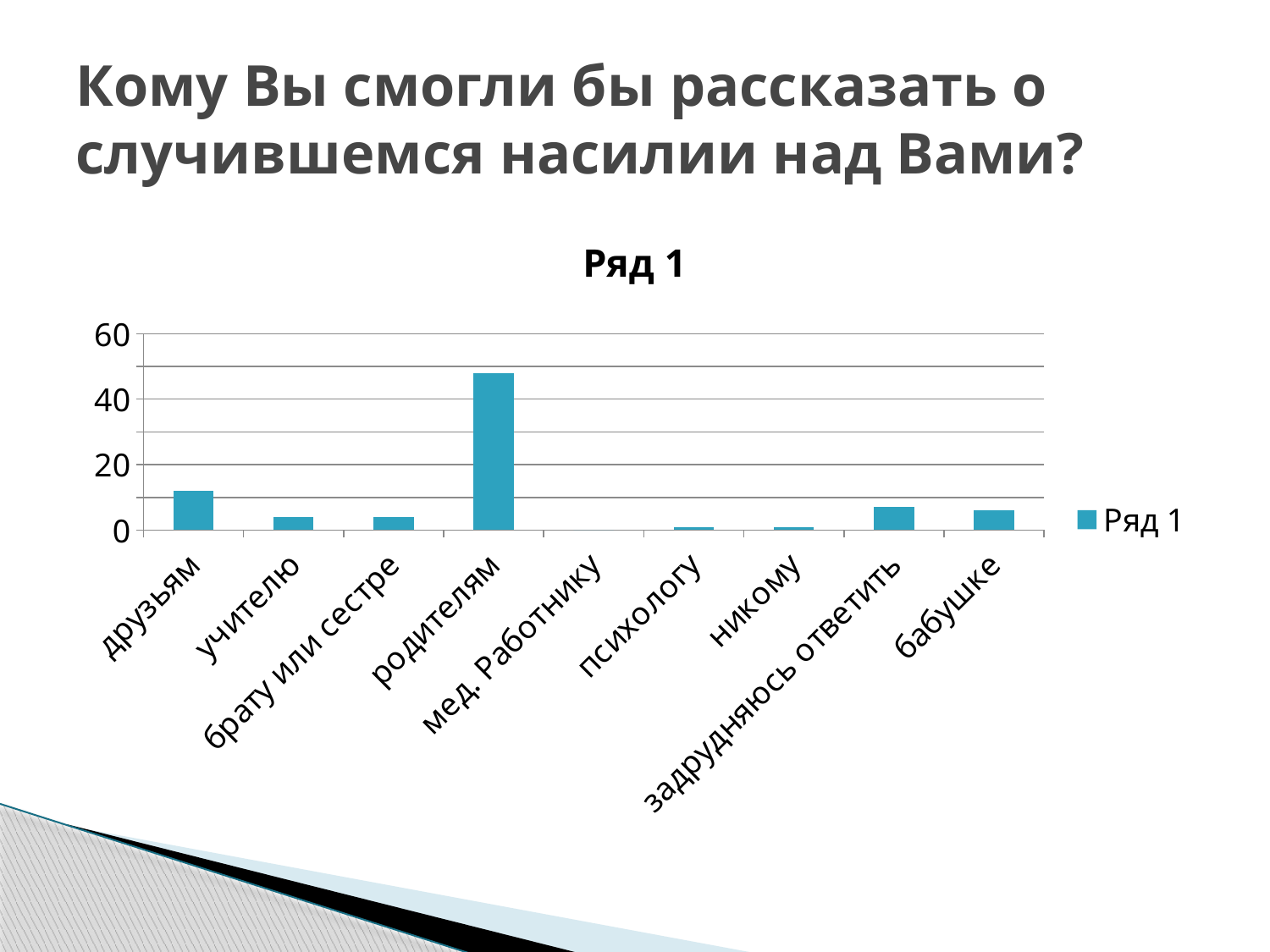
How many series does the legend list? 1 Is the value for родителям greater or less than 40? greater Which category has the lowest value? мед. Работнику Is the value for родителям greater or less than 60? less Which is larger, the value for родителям or the value for друзьям? родителям How many categories are shown on the x axis? 9 What is the title of the chart? Ряд 1 Which is larger, the value for задрудняюсь ответить or the value for психологу? задрудняюсь ответить Is the value for друзьям greater or less than 20? less Which category has the highest value? родителям Which is larger, the value for друзьям or the value for учителю? друзьям What kind of chart is shown on the slide? bar chart